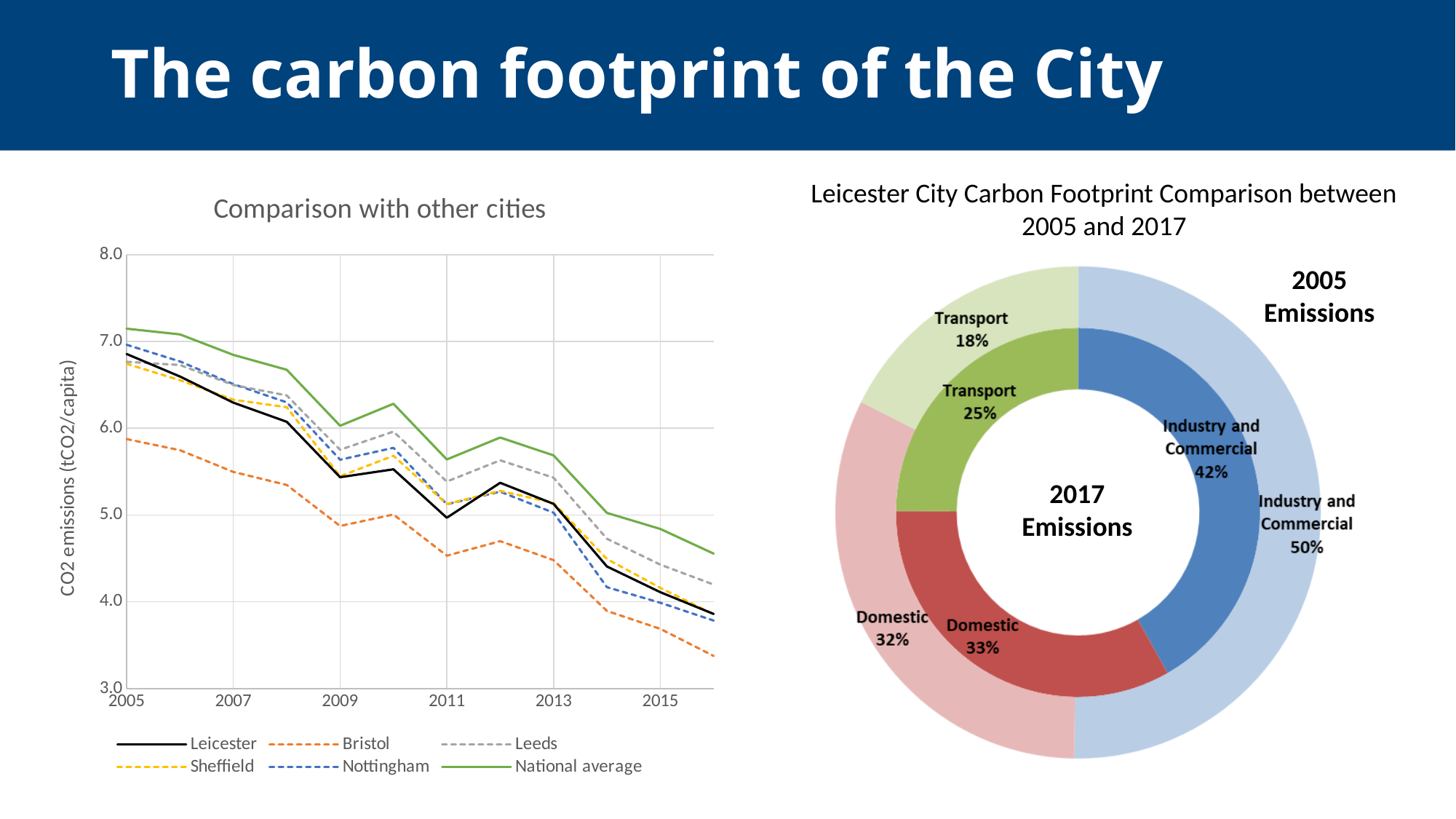
In the 'Leicester City Carbon Footprint Comparison' chart, what share of 2005 emissions came from Industry and Commercial? 50% How many series does the legend of the 'Comparison with other cities' chart list? 6 What kind of chart is the 'Comparison with other cities' chart? Line chart In the 'Leicester City Carbon Footprint Comparison' chart, by how many percentage points did the Transport share increase from 2005 to 2017? 7 percentage points In the 'Comparison with other cities' chart, is the value for Bristol in 2016 greater or less than 4.0? less In the 'Comparison with other cities' chart, which city has the lowest CO2 emissions per capita in 2015? Bristol In the 'Comparison with other cities' chart, is the value for Leicester in 2009 greater or less than 5.0? greater In the 'Leicester City Carbon Footprint Comparison' chart, which sector has the largest share of 2017 emissions? Industry and Commercial In the 'Comparison with other cities' chart, does the National average line rise or fall from 2005 to 2016? Fall What kind of chart is the 'Leicester City Carbon Footprint Comparison between 2005 and 2017' chart? Doughnut chart In the 'Comparison with other cities' chart, which series has the highest value in 2005? National average In the 'Leicester City Carbon Footprint Comparison' chart, what share of 2017 emissions came from Transport? 25%